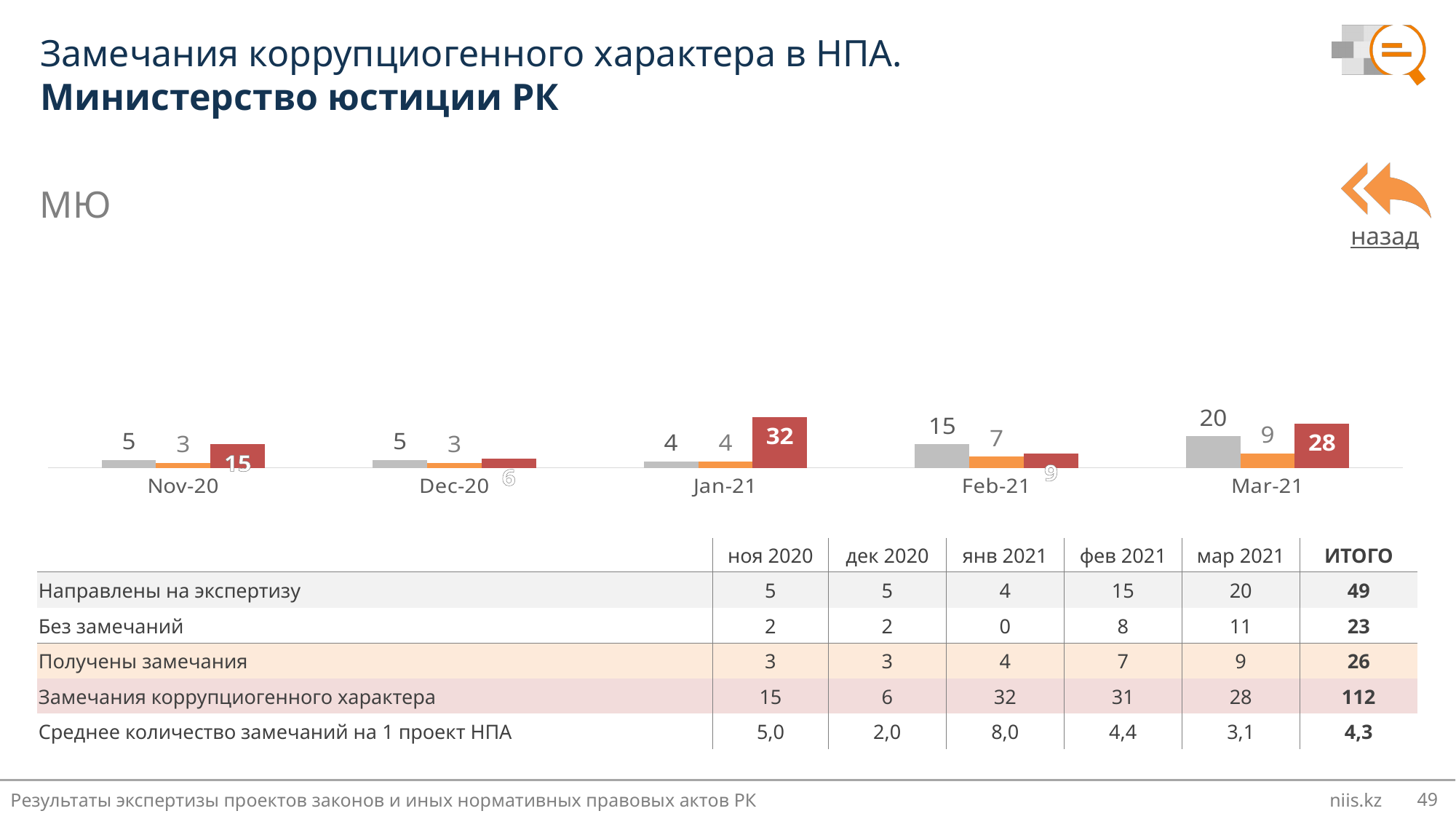
In which month is the red bar highest? Jan-21 In which month is the gray bar lowest? Jan-21 What is the value of the red bar for Nov-20? 15 Which month has the larger gray bar, Feb-21 or Mar-21? Mar-21 What type of chart is shown on the slide? bar chart How many bars are plotted for each month in the chart? 3 Do the gray bar values rise or fall from Jan-21 to Mar-21? rise What is the value of the orange bar for Feb-21? 7 What is the difference between the red bar values for Mar-21 and Nov-20? 13 How many months (categories) are shown on the x axis of the chart? 5 What is the value of the red bar for Jan-21? 32 What is the value of the gray bar for Mar-21? 20